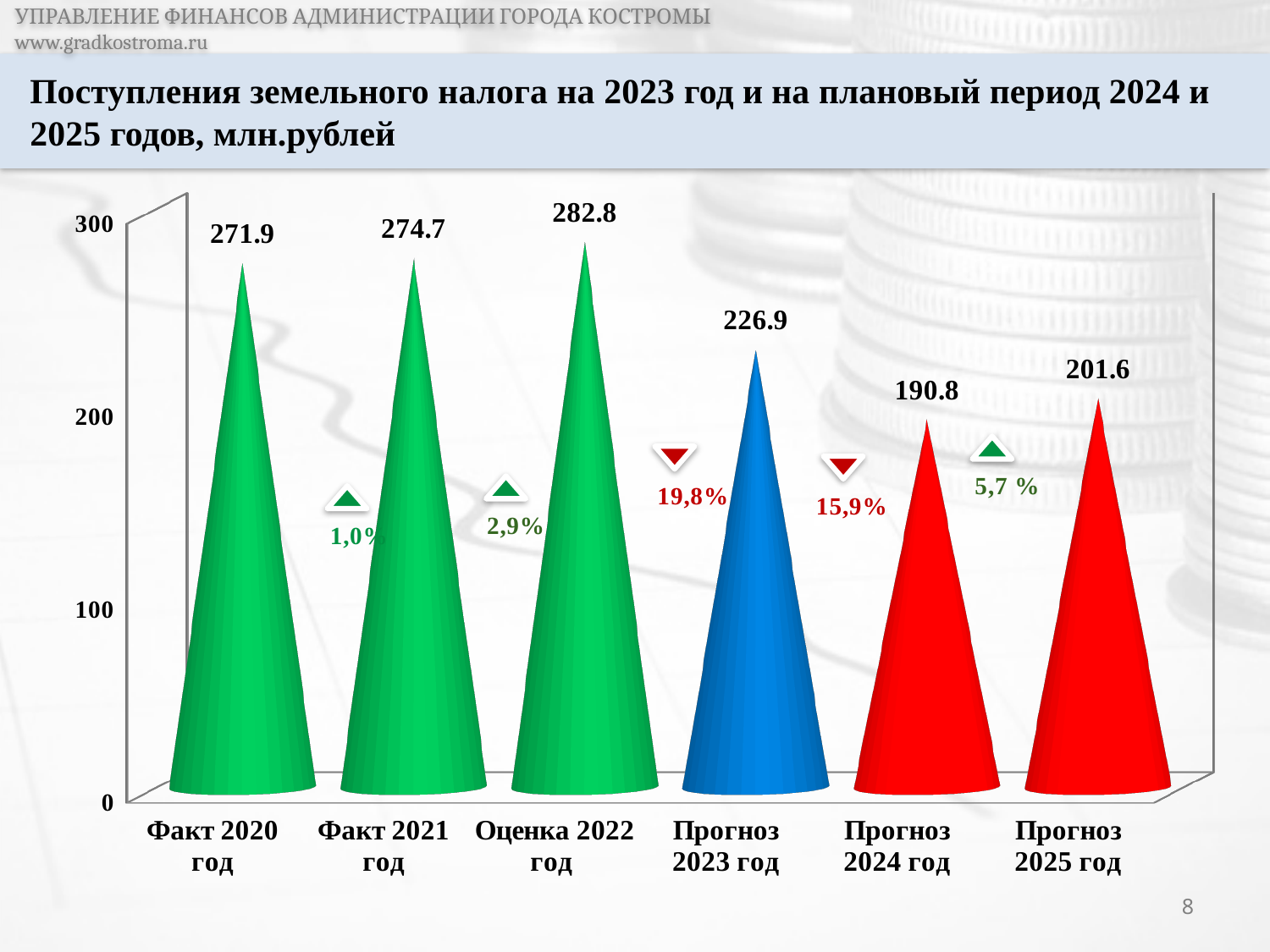
What is the difference between the values for Прогноз 2023 год and Прогноз 2024 год? 36.1 What is the value for Прогноз 2024 год? 190.8 Which is larger, the value for Прогноз 2025 год or the value for Прогноз 2023 год? Прогноз 2023 год What kind of chart is shown on the slide? Bar chart Which category has the lowest value? Прогноз 2024 год How many categories are shown on the x axis? 6 What is the value for Прогноз 2025 год? 201.6 What percentage change is shown between Прогноз 2023 год and Прогноз 2024 год? 15,9% What is the value for Оценка 2022 год? 282.8 What is the difference between the values for Оценка 2022 год and Факт 2020 год? 10.9 Which category has the highest value? Оценка 2022 год What is the value for Факт 2020 год? 271.9